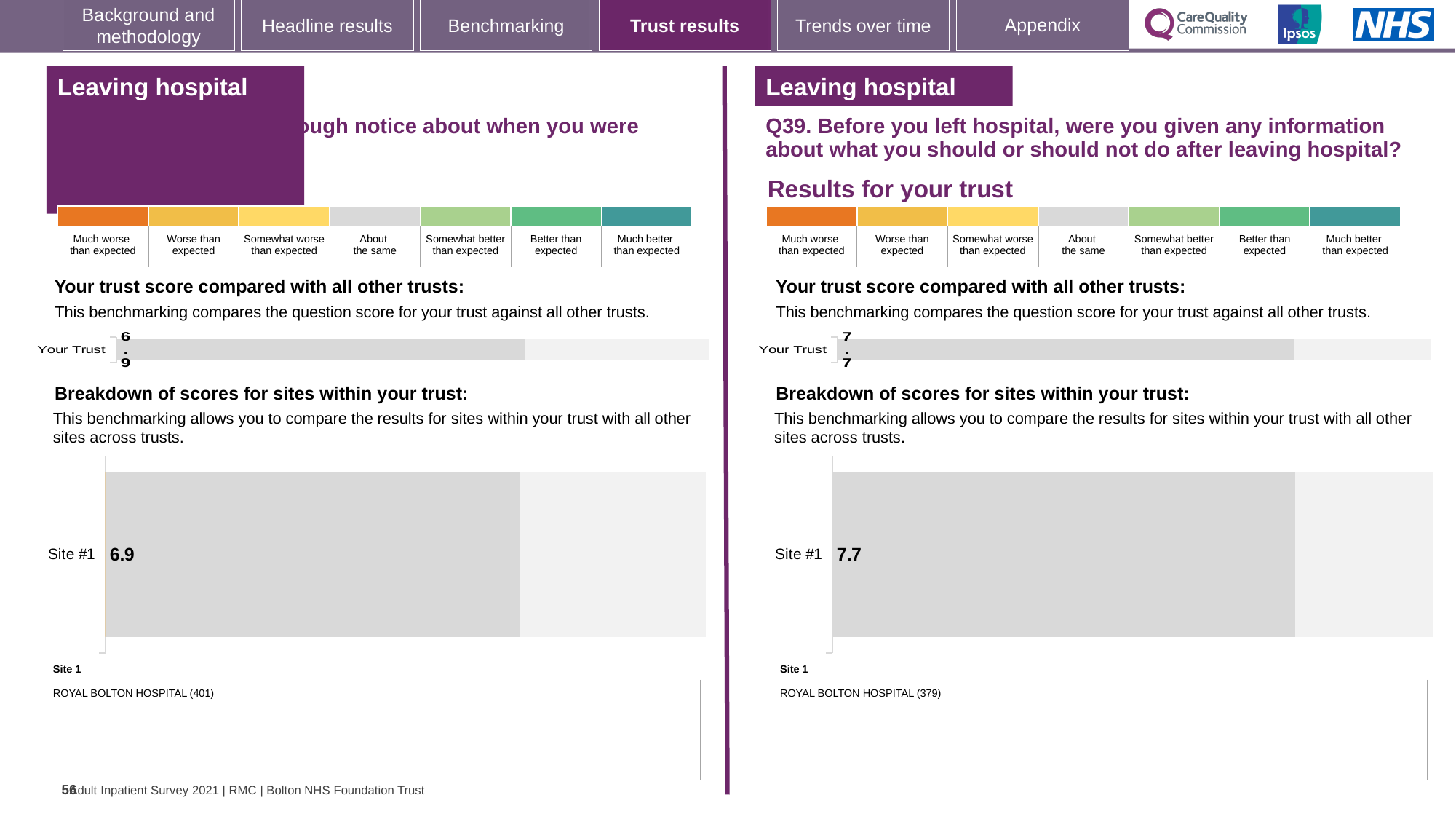
Is the Site #1 score on the left-hand chart larger or smaller than the Site #1 score on the right-hand chart (Q39)? smaller On the right-hand chart (Q39), what is the score shown for Your Trust? 7.7 On the left-hand chart, what is the score shown for Your Trust? 6.9 On the right-hand chart (Q39), what is the score shown for Site #1 in the breakdown of sites? 7.7 What kind of chart is used to show the Your Trust score on the right-hand side (Q39)? bar chart On the right-hand chart (Q39), which hospital is listed as Site 1? ROYAL BOLTON HOSPITAL What is the difference between the Your Trust score on the right-hand chart (Q39) and the Your Trust score on the left-hand chart? 0.8 Which chart shows the higher Your Trust score, the left-hand chart or the right-hand chart (Q39)? the right-hand chart (Q39) On the left-hand chart, what number is shown in brackets after ROYAL BOLTON HOSPITAL for Site 1? 401 On the left-hand chart, what is the score shown for Site #1 in the breakdown of sites? 6.9 How many sites are shown in the breakdown of scores for sites on the right-hand chart (Q39)? 1